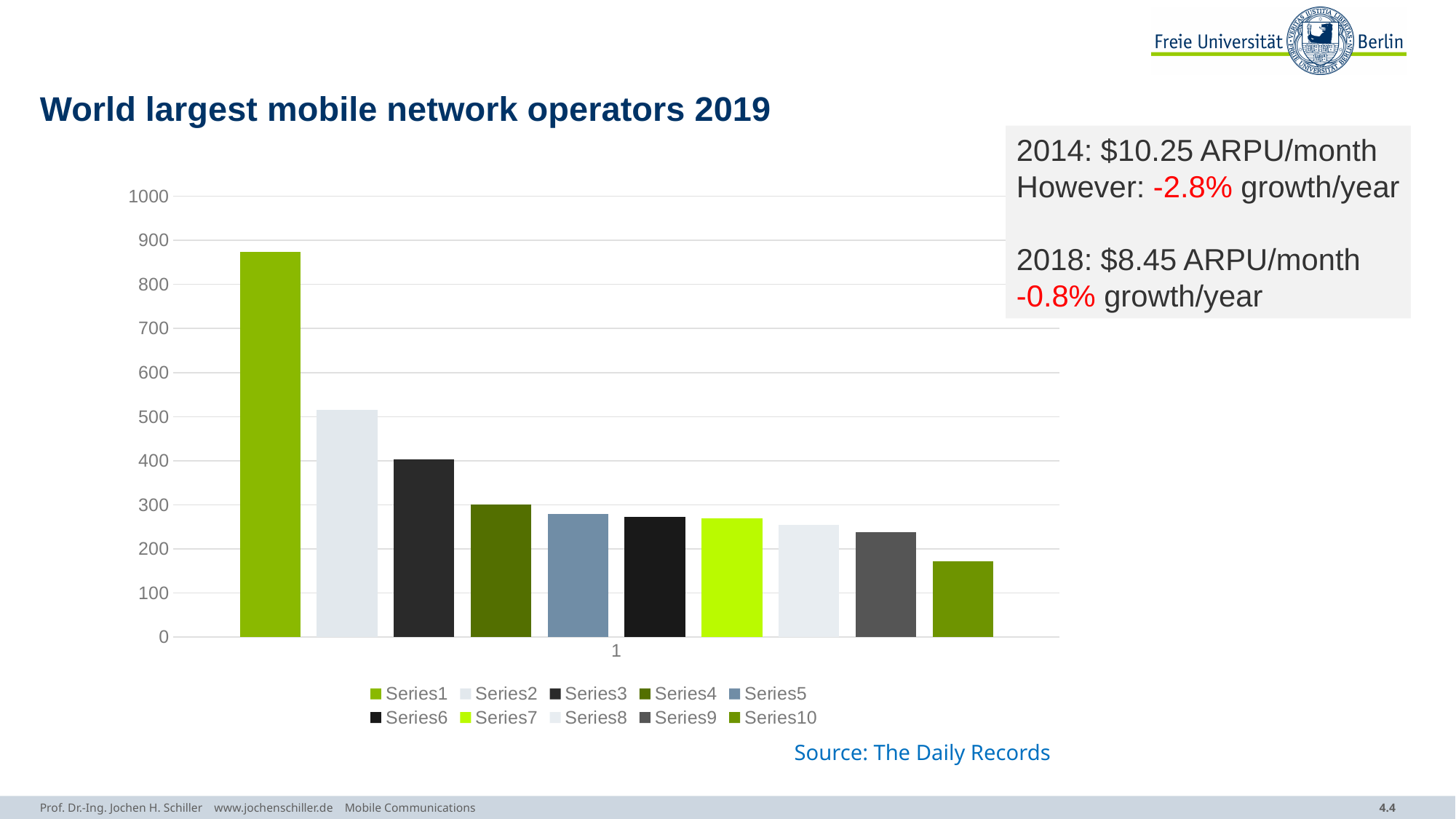
How many series does the legend list? 10 Is the value for Series1 greater or less than 800? greater Which is larger, the value for Series3 or the value for Series10? Series3 Is the value for Series10 greater or less than 200? less Which series has the lowest value? Series10 Which series has the highest value? Series1 What is the title of the slide containing the chart? World largest mobile network operators 2019 What kind of chart is shown on the slide? bar chart Do the bar values rise or fall from Series1 to Series10? fall Is the value for Series3 greater or less than 500? less Which is larger, the value for Series1 or the value for Series2? Series1